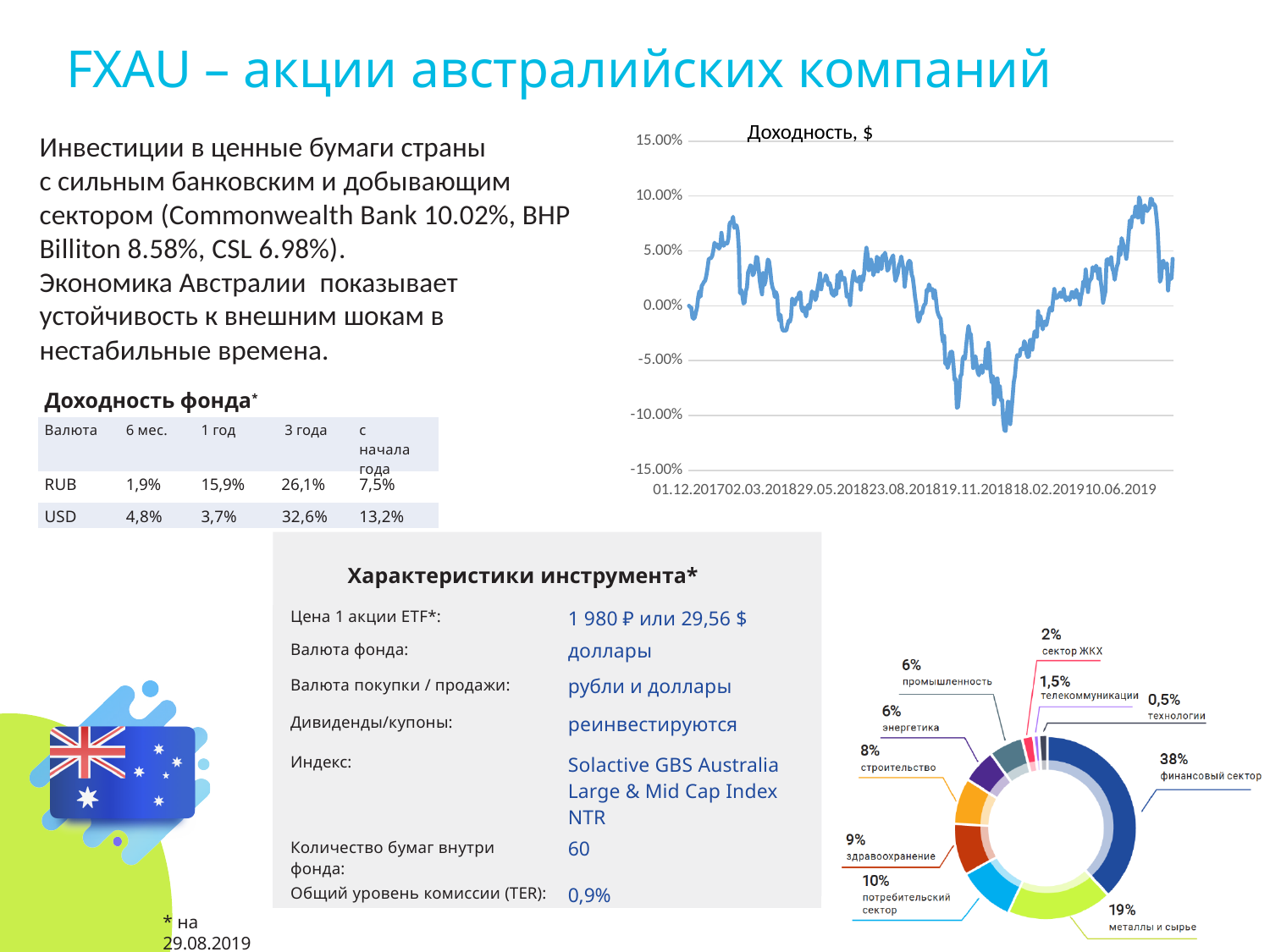
In the sector breakdown donut chart at the bottom right, what share does металлы и сырье have? 19% In the sector breakdown donut chart at the bottom right, which has the larger share: здравоохранение or строительство? здравоохранение In the sector breakdown donut chart at the bottom right, how many sectors are shown? 10 In the sector breakdown donut chart at the bottom right, what is the difference between the shares of финансовый сектор and металлы и сырье? 19% In the sector breakdown donut chart at the bottom right, which sector has the smallest share? технологии In the chart titled "Доходность, $", is the value at the last date shown greater or less than 0.00%? greater In the chart titled "Доходность, $", is the highest point of the line greater or less than 5.00%? greater What kind of chart is the chart in the bottom right of the slide showing sector breakdown? pie chart (donut) In the chart titled "Доходность, $", is the lowest point of the line greater or less than -5.00%? less What kind of chart is the chart titled "Доходность, $"? line chart In the sector breakdown donut chart at the bottom right, which sector has the largest share? финансовый сектор In the sector breakdown donut chart at the bottom right, what share does финансовый сектор have? 38%